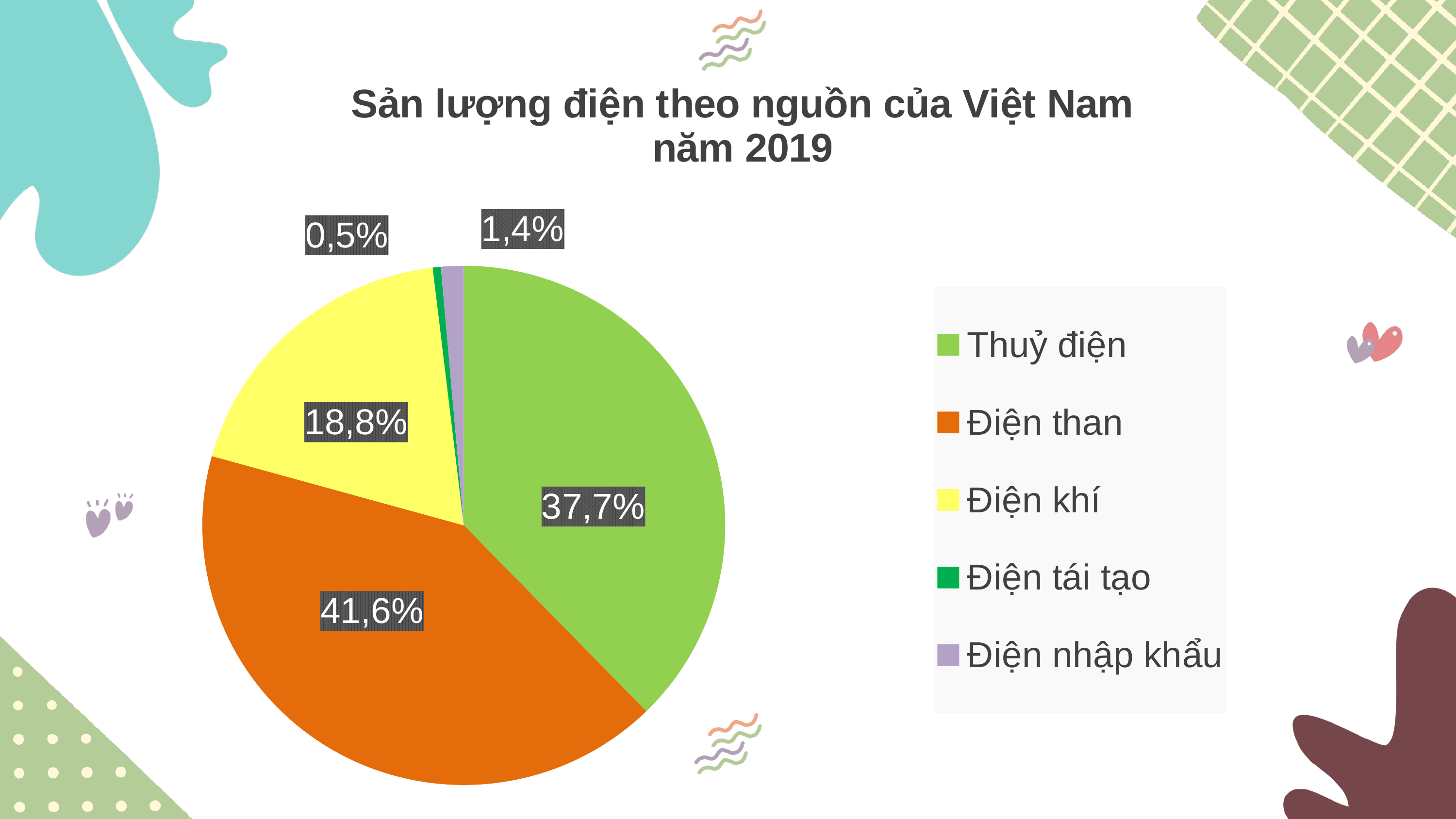
Which source has the smallest share of the pie? Điện tái tạo Which is larger, the share for Điện khí or the share for Điện nhập khẩu? Điện khí What is the share for Điện tái tạo? 0,5% What is the share for Điện than? 41,6% What is the share for Điện nhập khẩu? 1,4% What is the share for Thuỷ điện? 37,7% What is the share for Điện khí? 18,8% What is the difference in percentage points between Điện than and Thuỷ điện? 3,9 How many slices does the pie chart have? 5 What kind of chart is shown on the slide? pie chart What is the title of the chart? Sản lượng điện theo nguồn của Việt Nam năm 2019 Which source has the largest share of the pie? Điện than